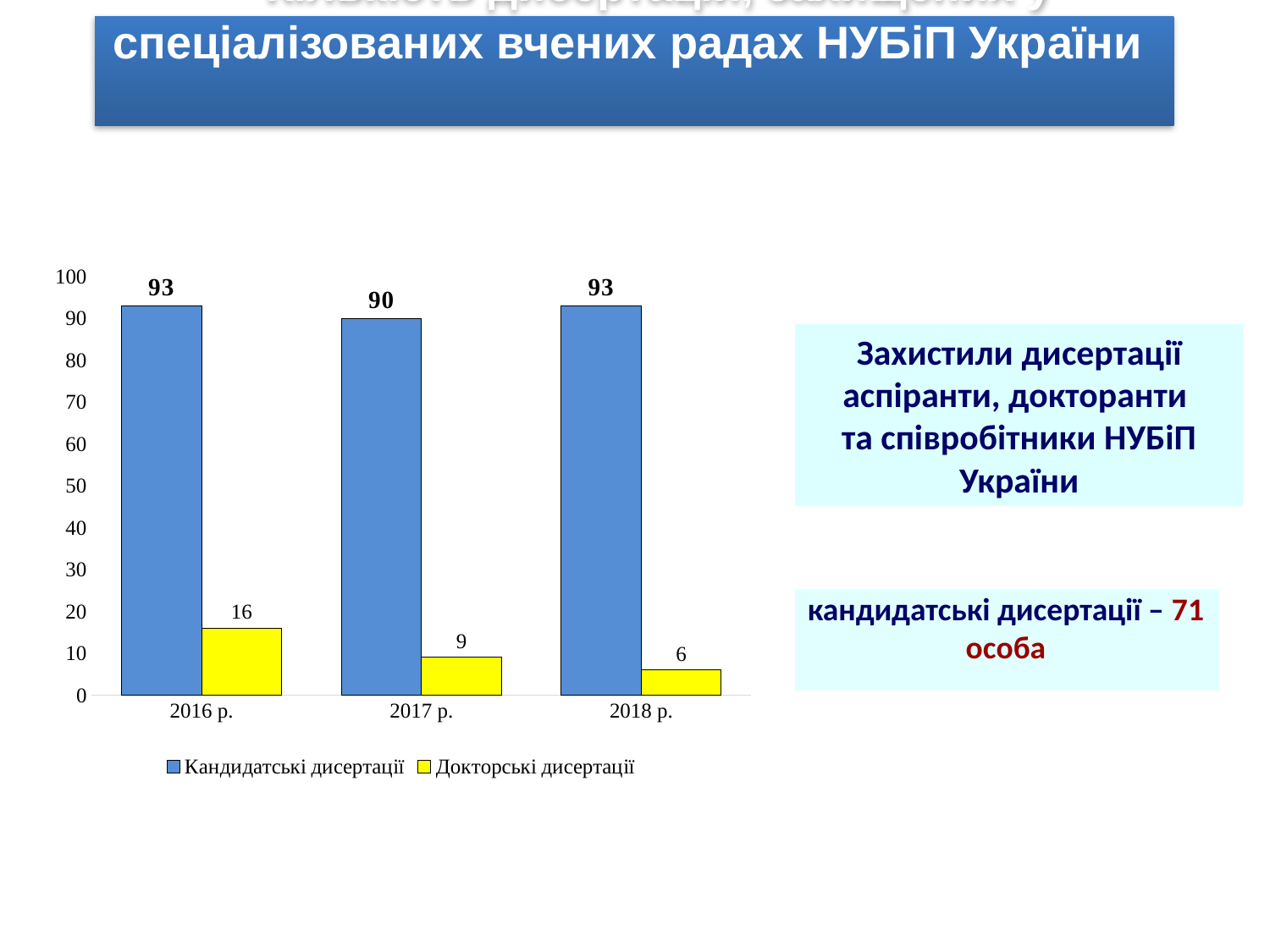
What is the value for Кандидатські дисертації in 2016 р.? 93 Do the values for Докторські дисертації rise or fall from 2016 р. to 2018 р.? fall What colour are the bars for Докторські дисертації? yellow How many years are shown on the x axis? 3 Which is larger: Кандидатські дисертації in 2017 р. or in 2018 р.? 2018 р. Which year has the highest value for Докторські дисертації? 2016 р. Which year has the lowest value for Кандидатські дисертації? 2017 р. How many series does the legend list? 2 What is the value for Докторські дисертації in 2017 р.? 9 What is the value for Докторські дисертації in 2018 р.? 6 What kind of chart is shown? bar chart What is the difference between Докторські дисертації in 2016 р. and 2018 р.? 10